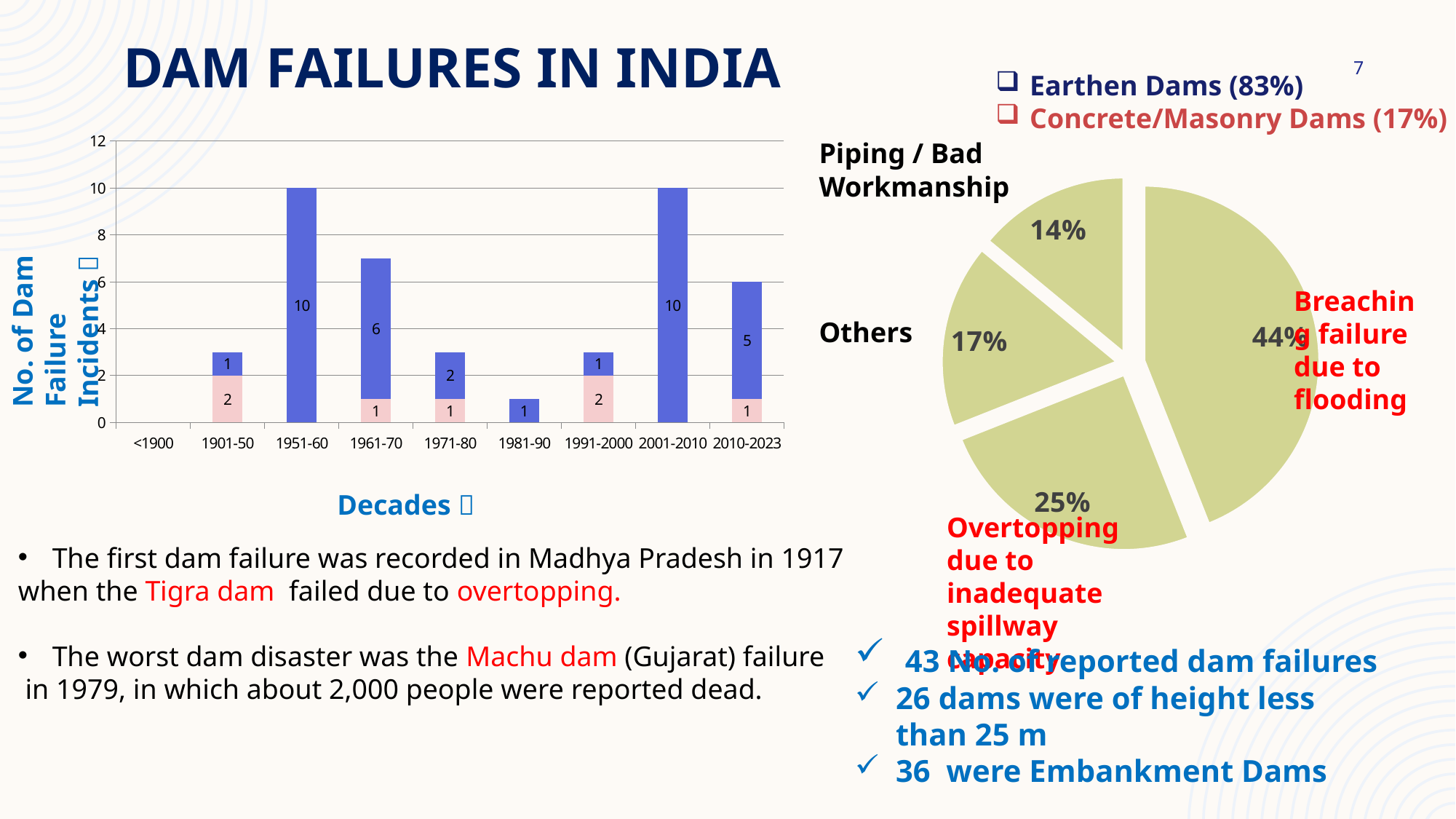
In the bar chart of dam failure incidents by decade, what is the total number of incidents in the stacked bar for 1961-70? 7 In the bar chart of dam failure incidents by decade, how many earthen dam failure incidents are shown for 1951-60? 10 In the pie chart of dam failure causes, what share is attributed to Others? 17% What kind of chart is the chart on the left showing dam failure incidents by decade? Bar chart In the bar chart of dam failure incidents by decade, which has more earthen dam incidents: 2001-2010 or 1981-90? 2001-2010 In the pie chart of dam failure causes, which cause has the largest share? Breaching failure due to flooding In the bar chart of dam failure incidents by decade, what is the total number of incidents in the stacked bar for 2010-2023? 6 In the pie chart of dam failure causes, which cause has the smallest share? Piping / Bad Workmanship In the bar chart of dam failure incidents by decade, how many concrete/masonry dam failure incidents are shown for 1901-50? 2 In the bar chart of dam failure incidents by decade, how many decade categories are shown on the x axis? 9 In the bar chart of dam failure incidents by decade, what is the difference between the earthen dam incidents in 1951-60 and in 1961-70? 4